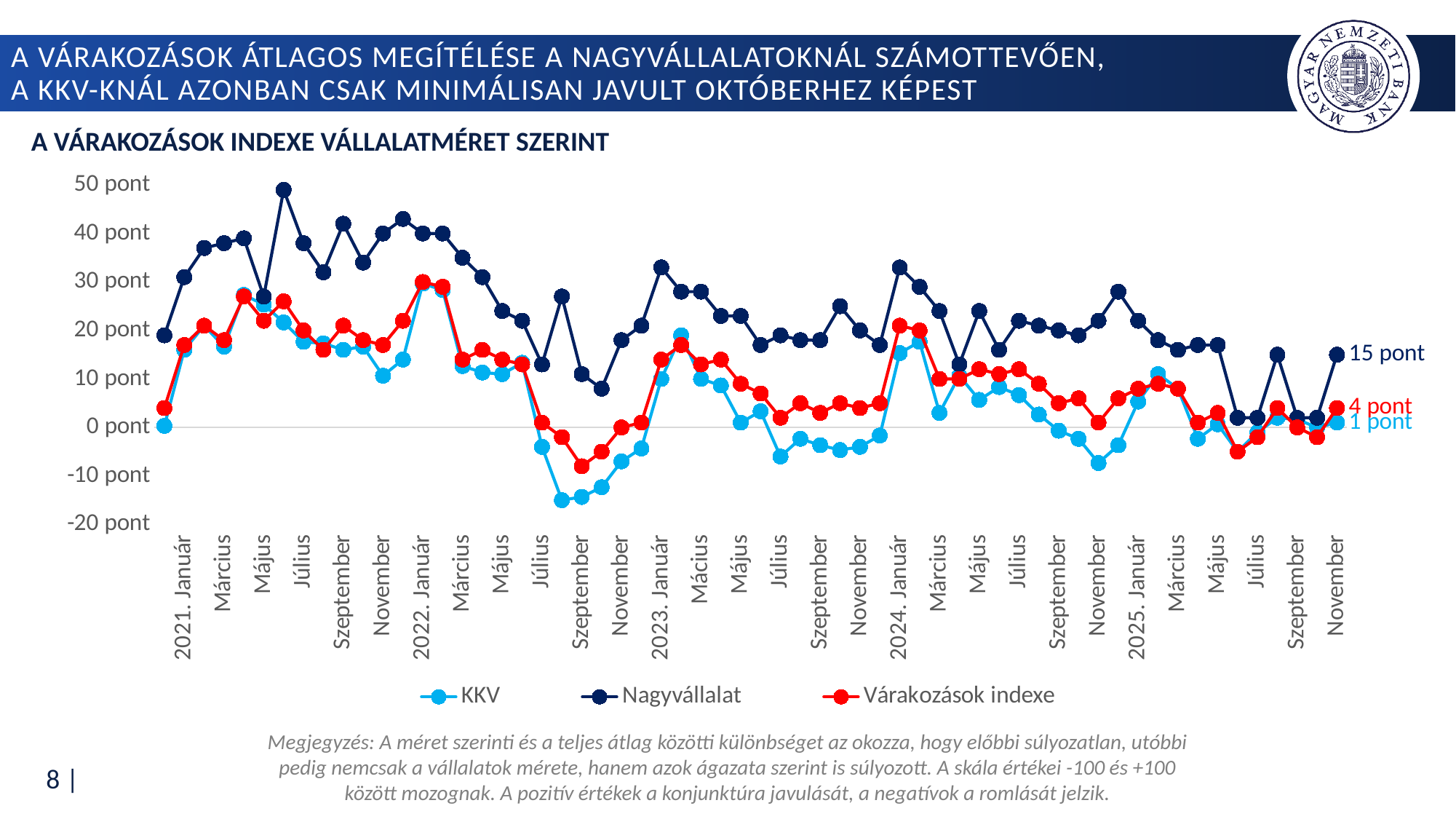
At November 2025, what is the difference between the Nagyvállalat value and the KKV value? 14 pont What kind of chart is shown on the slide? Line chart At November 2025, which series has the higher value: KKV or Nagyvállalat? Nagyvállalat Is the Nagyvállalat value in 2023. Január greater or less than 30 pont? greater What is the value of the KKV series at the last point (November 2025)? 1 pont Which series has the lowest value at November 2025? KKV Is the KKV value in Szeptember 2022 greater or less than -10 pont? less How many series does the legend list? 3 At November 2025, what is the difference between the Nagyvállalat value and the Várakozások indexe value? 11 pont What is the value of the Nagyvállalat series at the last point (November 2025)? 15 pont Does the KKV series rise or fall between Május 2022 and Szeptember 2022? Fall What is the value of the Várakozások indexe series at the last point (November 2025)? 4 pont